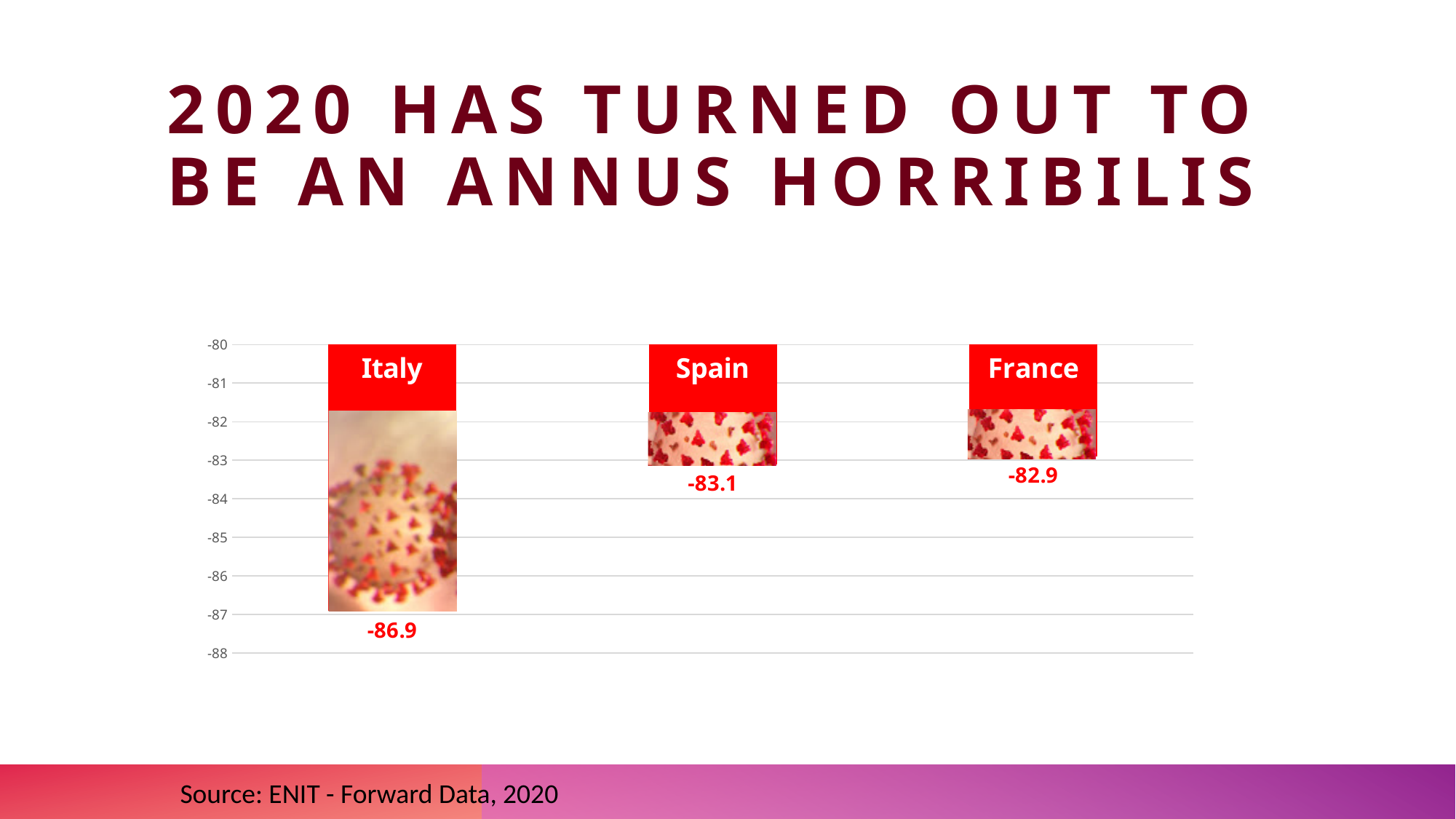
Is the value for Italy greater or less than -85? less Which has the larger (less negative) value, Spain or France? France What kind of chart is shown on the slide? bar chart What is the difference between the values for Italy and Spain? 3.8 Which country has the lowest (most negative) value? Italy What is the value shown for France? -82.9 How many countries are shown in the chart? 3 What is the difference between the values for Italy and France? 4.0 What source is cited for the chart data? ENIT - Forward Data, 2020 What is the value shown for Italy? -86.9 Which country has the highest (least negative) value? France What is the value shown for Spain? -83.1